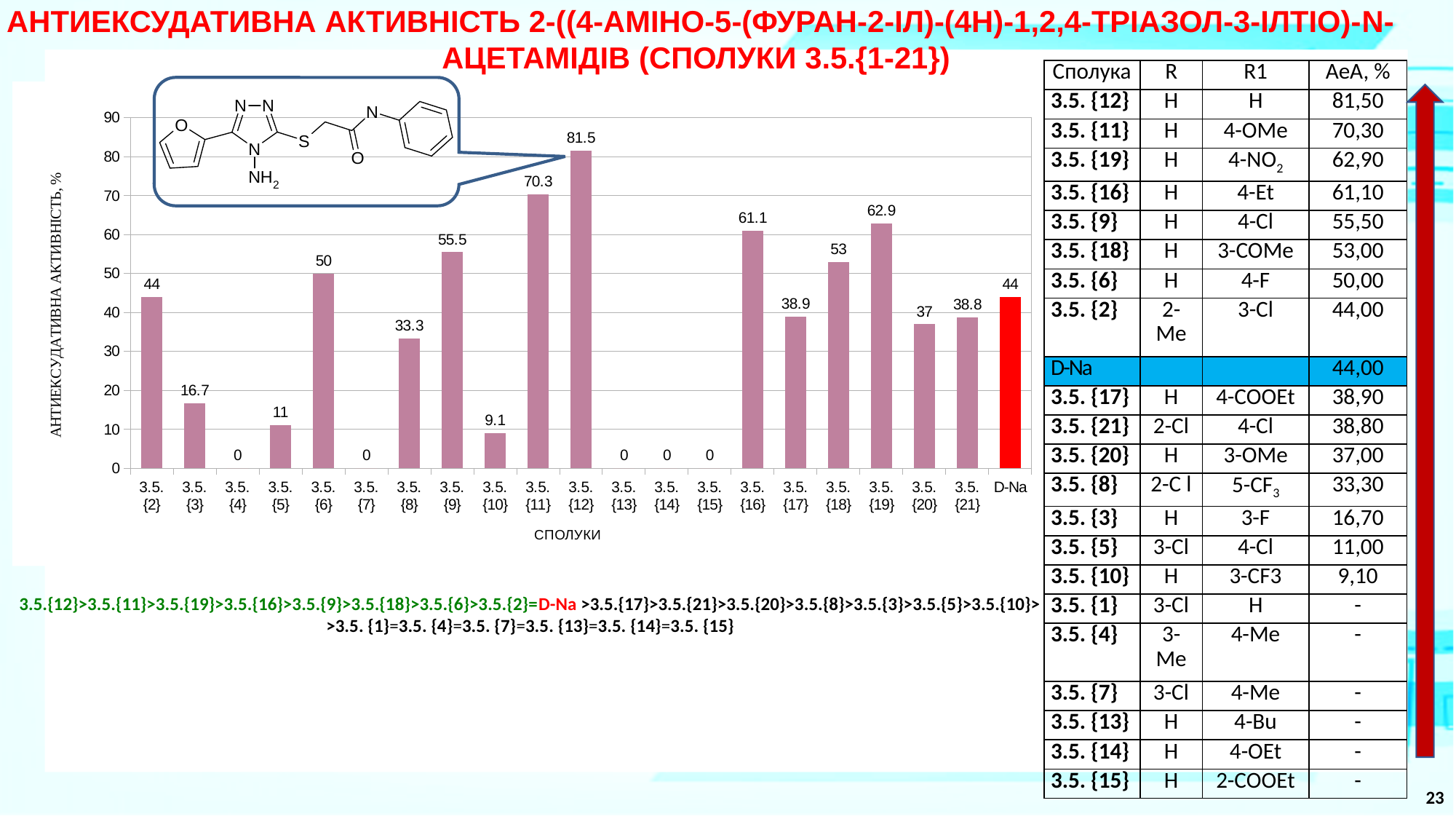
Which category has the highest value in the chart? 3.5.{12} How many categories are shown on the x axis of the chart? 21 What is the value for D-Na in the chart? 44 Which is larger, the value for 3.5.{6} or the value for 3.5.{8}? 3.5.{6} What is the difference between the values for 3.5.{16} and 3.5.{17}? 22.2 What is the difference between the values for 3.5.{12} and 3.5.{11}? 11.2 What kind of chart is shown on the slide? bar chart What is the value for 3.5.{12} in the chart? 81.5 What is the value for 3.5.{10} in the chart? 9.1 What is the label of the y axis of the chart? АНТИЕКСУДАТИВНА АКТИВНІСТЬ, % How many categories in the chart have a value of 0? 5 Which is larger, the value for 3.5.{19} or the value for 3.5.{18}? 3.5.{19}